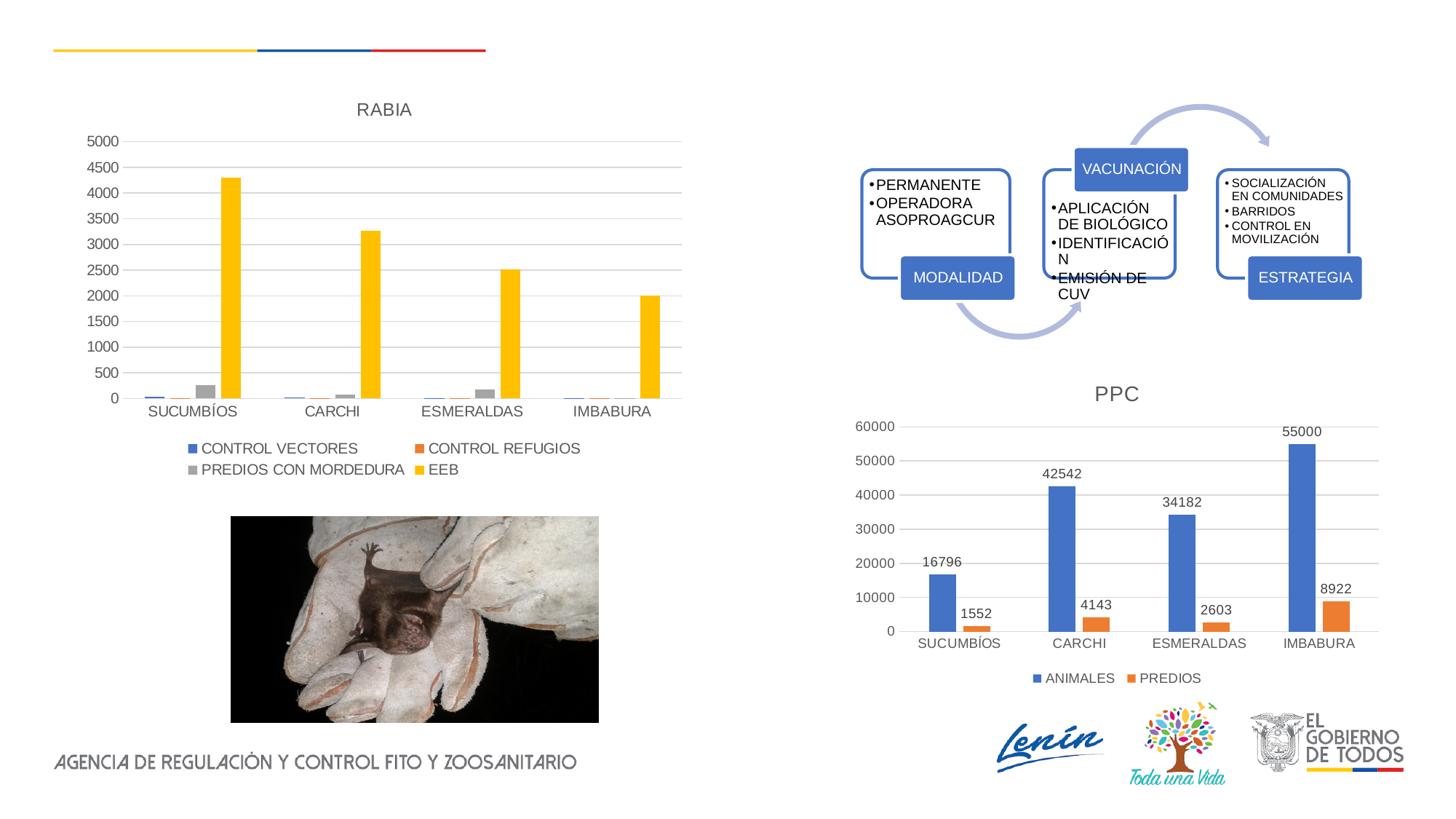
In the PPC chart, which province has the highest ANIMALES value? IMBABURA In the PPC chart, what is the difference between the ANIMALES values for IMBABURA and SUCUMBÍOS? 38204 In the RABIA chart, is the EEB value for SUCUMBÍOS greater or less than 4000? greater In the PPC chart, which is larger: the PREDIOS value for CARCHI or for ESMERALDAS? CARCHI How many series does the legend of the PPC chart list? 2 In the RABIA chart, is the EEB value for IMBABURA greater or less than 2500? less How many series does the legend of the RABIA chart list? 4 What kind of chart is the PPC chart? Bar chart In the RABIA chart, which province has the highest EEB value? SUCUMBÍOS In the PPC chart, what is the PREDIOS value for IMBABURA? 8922 In the PPC chart, which province has the lowest PREDIOS value? SUCUMBÍOS In the PPC chart, what is the ANIMALES value for CARCHI? 42542